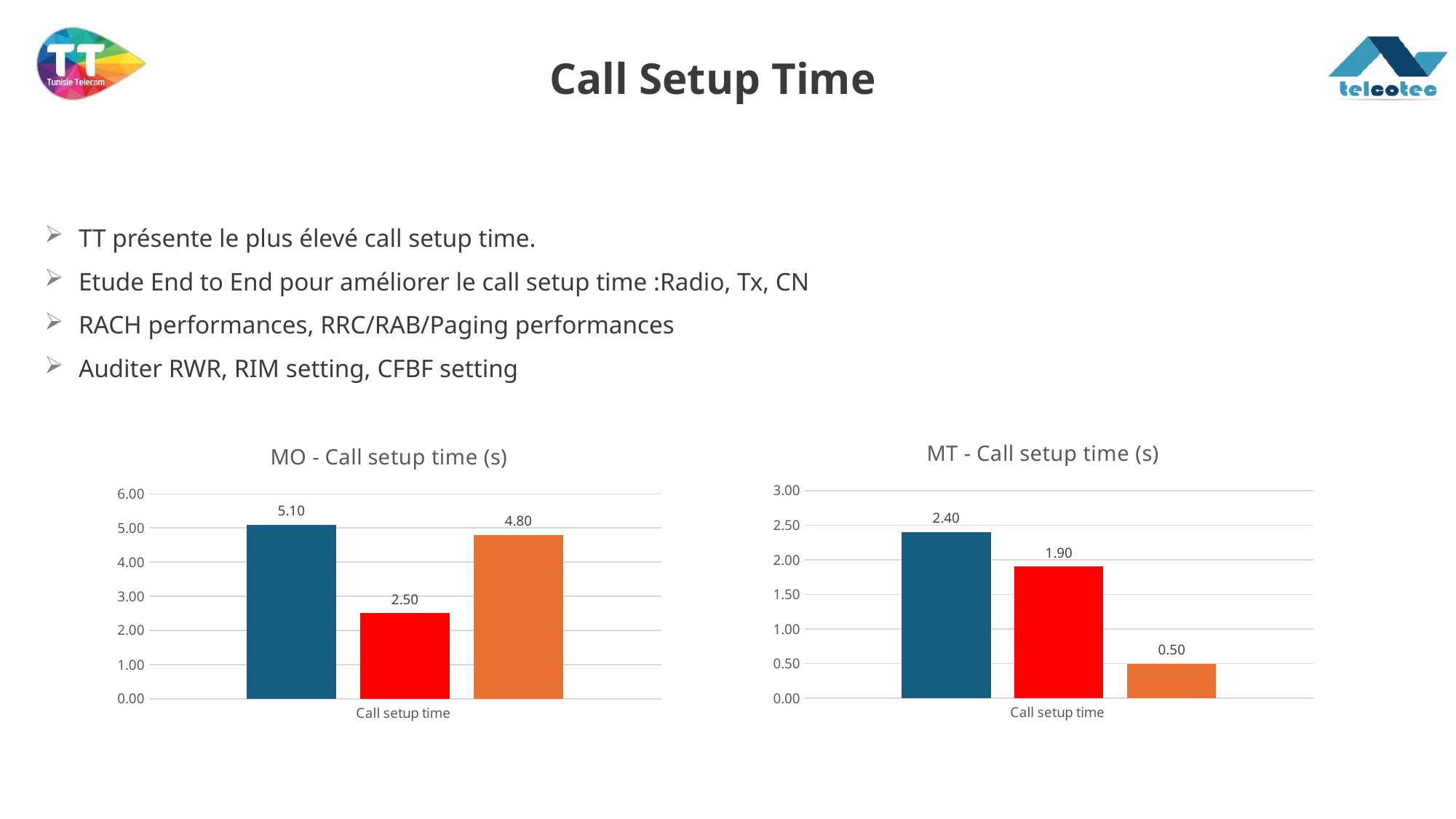
In the MT - Call setup time (s) chart, what value is labelled on the blue bar? 2.40 In the MO - Call setup time (s) chart, what is the difference between the blue bar and the red bar? 2.60 In the MT - Call setup time (s) chart, which bar colour has the lowest value? orange What type of chart is the MO - Call setup time (s) chart? bar chart In the MT - Call setup time (s) chart, what is the difference between the blue bar and the red bar? 0.50 In the MO - Call setup time (s) chart, what value is labelled on the blue bar? 5.10 In the MO - Call setup time (s) chart, what value is labelled on the orange bar? 4.80 How many bars are plotted in the MT - Call setup time (s) chart? 3 In the MO - Call setup time (s) chart, what value is labelled on the red bar? 2.50 In the MO - Call setup time (s) chart, which bar colour has the highest value? blue In the MT - Call setup time (s) chart, what value is labelled on the orange bar? 0.50 In the MO - Call setup time (s) chart, is the orange bar larger or smaller than the red bar? larger